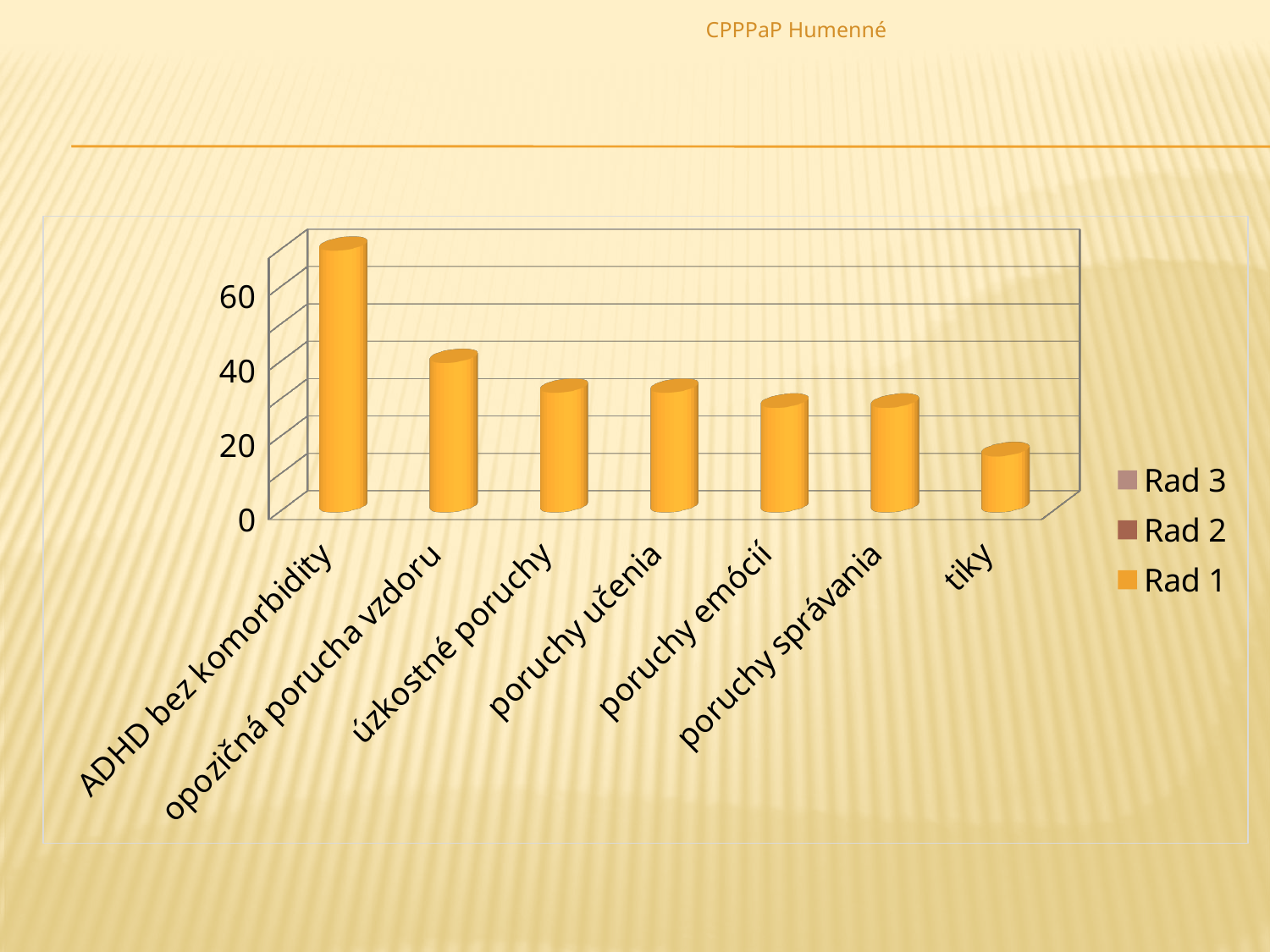
How many categories are shown on the x axis of the chart? 7 Is the value for poruchy emócií greater or less than 20? greater Which is larger, the value for opozičná porucha vzdoru or the value for tiky? opozičná porucha vzdoru Is the value for ADHD bez komorbidity greater or less than 60? greater Do the values generally rise or fall moving from left to right along the x axis? fall Which category has the lowest value in the chart? tiky Which legend entry corresponds to the orange bars in the chart? Rad 1 Is the value for úzkostné poruchy greater or less than 40? less What kind of chart is shown on the slide? bar chart How many series does the chart's legend list? 3 Which category has the highest value in the chart? ADHD bez komorbidity